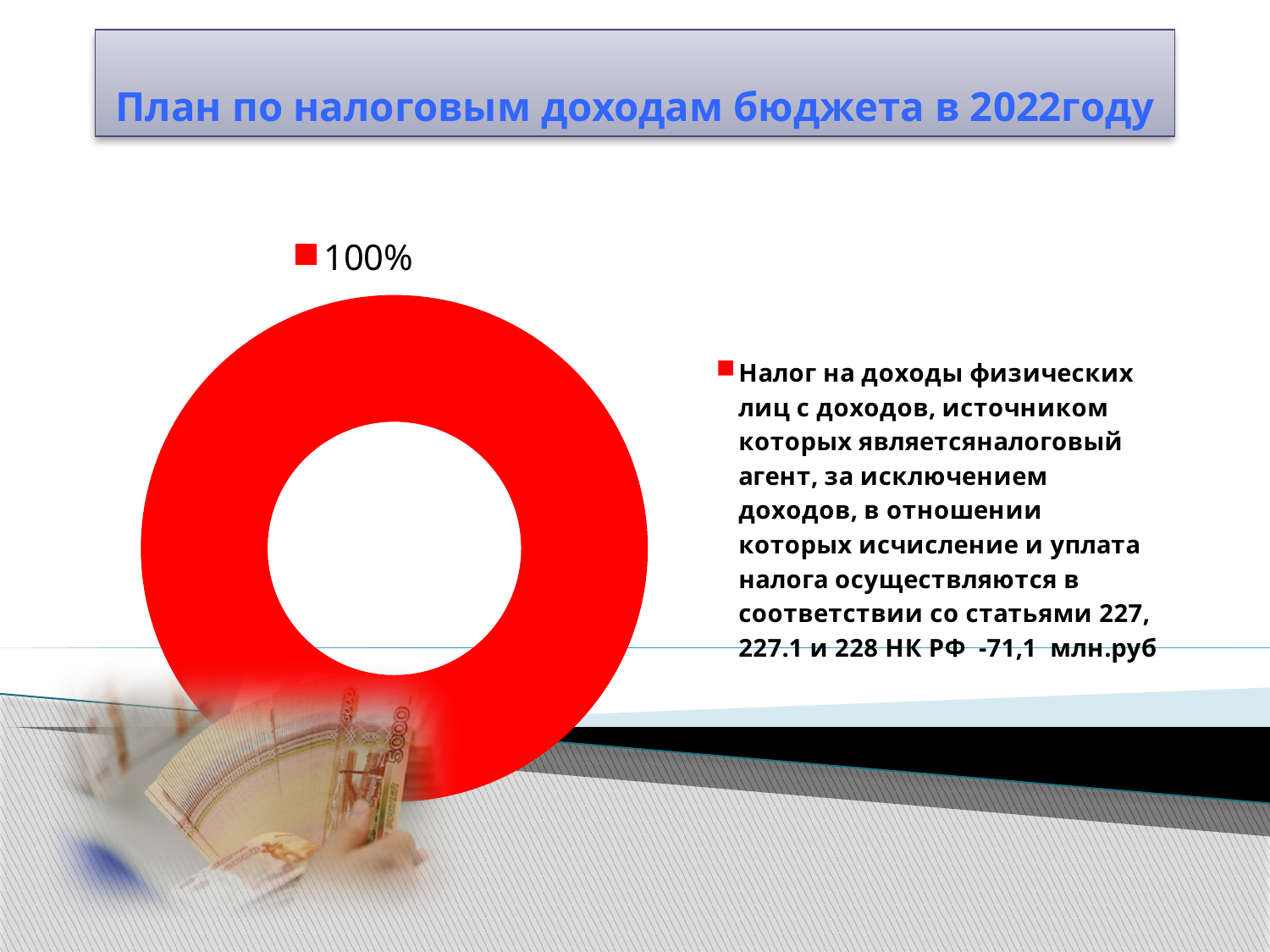
What amount in млн.руб is stated on the slide for the personal income tax (НДФЛ) item shown in the chart? 71,1 млн.руб What colour is the slice in the doughnut chart? Red What is the title of the slide containing the chart? План по налоговым доходам бюджета в 2022году What kind of chart is shown on the slide? Doughnut (pie) chart How many slices does the doughnut chart have? 1 What share of the doughnut chart does the single slice represent? 100% How many entries does the chart legend list? 1 What label is shown in the chart legend? 100%